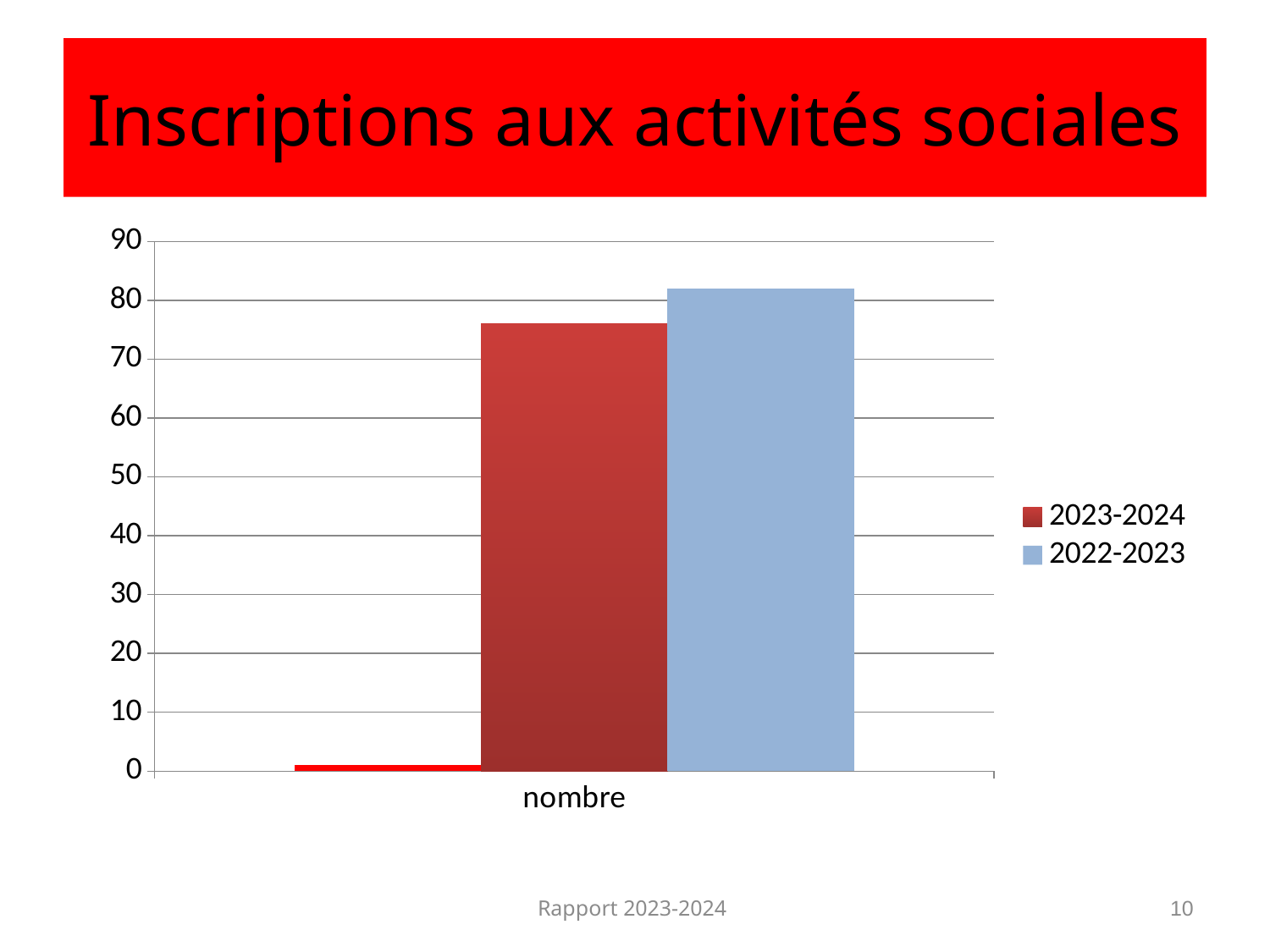
What is the label of the category on the x axis? nombre What kind of chart is shown on the slide? bar chart Is the value for 2022-2023 greater or less than 90? less Is the value for 2023-2024 greater or less than 70? greater Which series has the larger value for "nombre": 2023-2024 or 2022-2023? 2022-2023 How many categories are shown on the x axis of the chart? 1 Which series has the highest bar in the chart? 2022-2023 Is the value for 2022-2023 greater or less than 80? greater What is the title shown above the chart on the slide? Inscriptions aux activités sociales What is the highest value shown on the vertical axis of the chart? 90 How many series does the chart legend list? 2